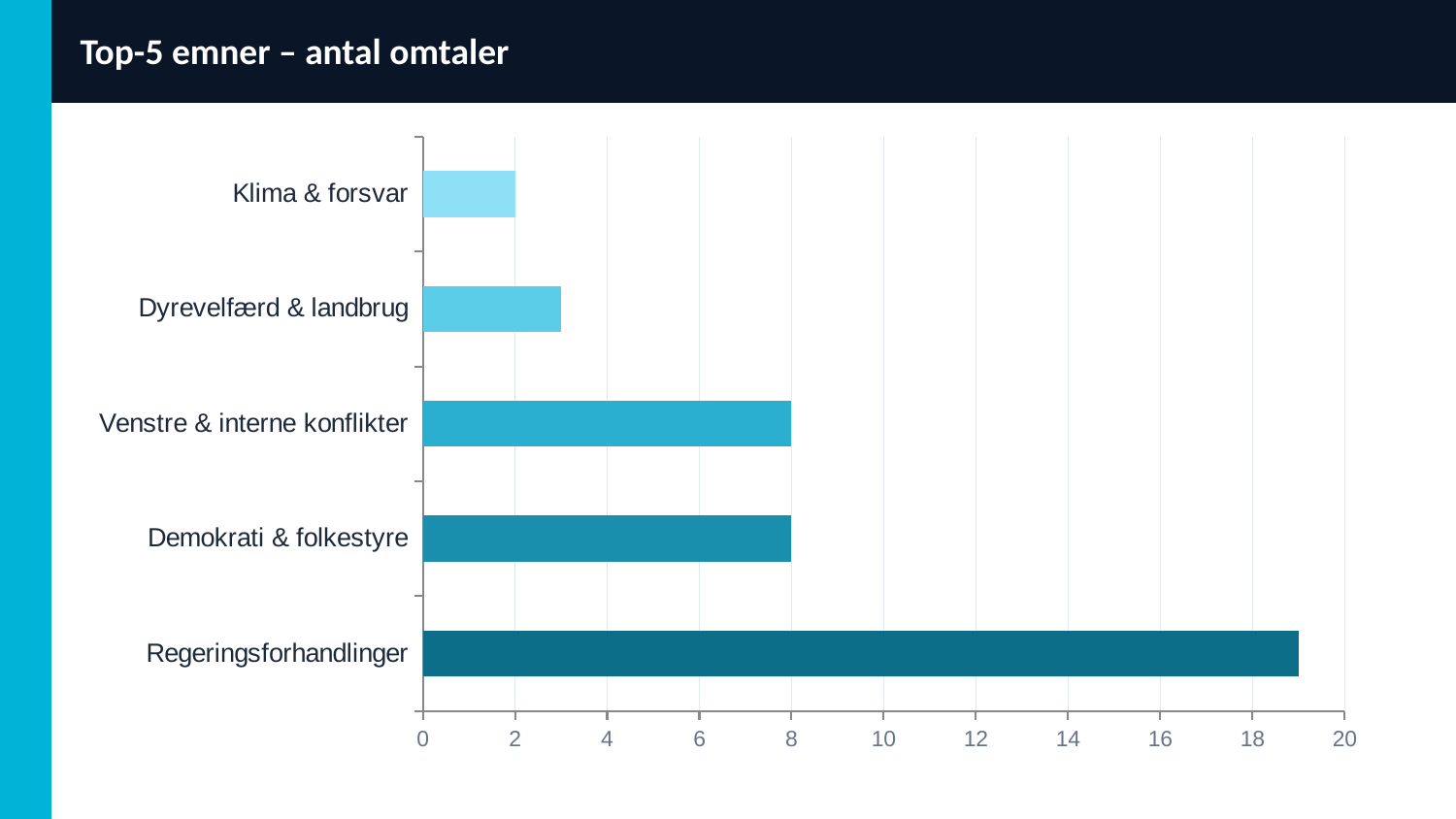
How many categories are shown in the chart? 5 What is the value for Demokrati & folkestyre? 8 Which is larger, the value for Regeringsforhandlinger or the value for Demokrati & folkestyre? Regeringsforhandlinger Is the value for Dyrevelfærd & landbrug greater or less than 4? less What is the value for Klima & forsvar? 2 What is the value for Venstre & interne konflikter? 8 What is the difference between the values for Venstre & interne konflikter and Klima & forsvar? 6 Is the value for Regeringsforhandlinger greater or less than 18? greater What is the title of the slide? Top-5 emner – antal omtaler Which category has the lowest value? Klima & forsvar What kind of chart is shown on the slide? Bar chart Which category has the highest value? Regeringsforhandlinger